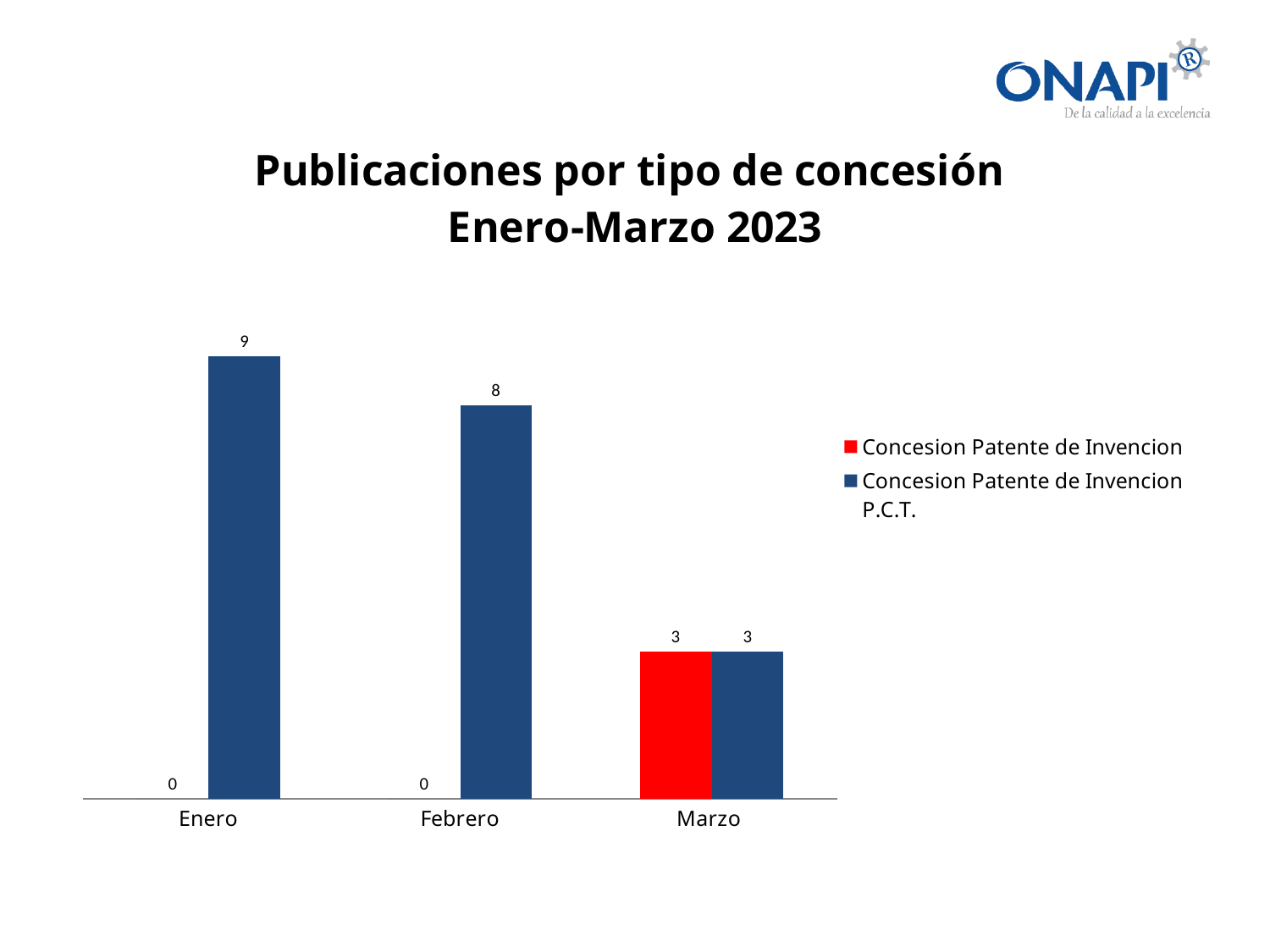
Which is larger: the Concesion Patente de Invencion P.C.T. value for Febrero or for Marzo? Febrero What is the value for Concesion Patente de Invencion in Marzo? 3 Does the Concesion Patente de Invencion P.C.T. series rise or fall from Enero to Marzo? Fall What kind of chart is shown on the slide? Bar chart How many series does the legend list? 2 How many months are shown on the x axis? 3 Which month has the highest value for Concesion Patente de Invencion P.C.T.? Enero What is the value for Concesion Patente de Invencion in Enero? 0 What is the value for Concesion Patente de Invencion P.C.T. in Febrero? 8 What is the difference between the Concesion Patente de Invencion P.C.T. values for Enero and Febrero? 1 What is the value for Concesion Patente de Invencion P.C.T. in Enero? 9 Which month has the lowest value for Concesion Patente de Invencion P.C.T.? Marzo